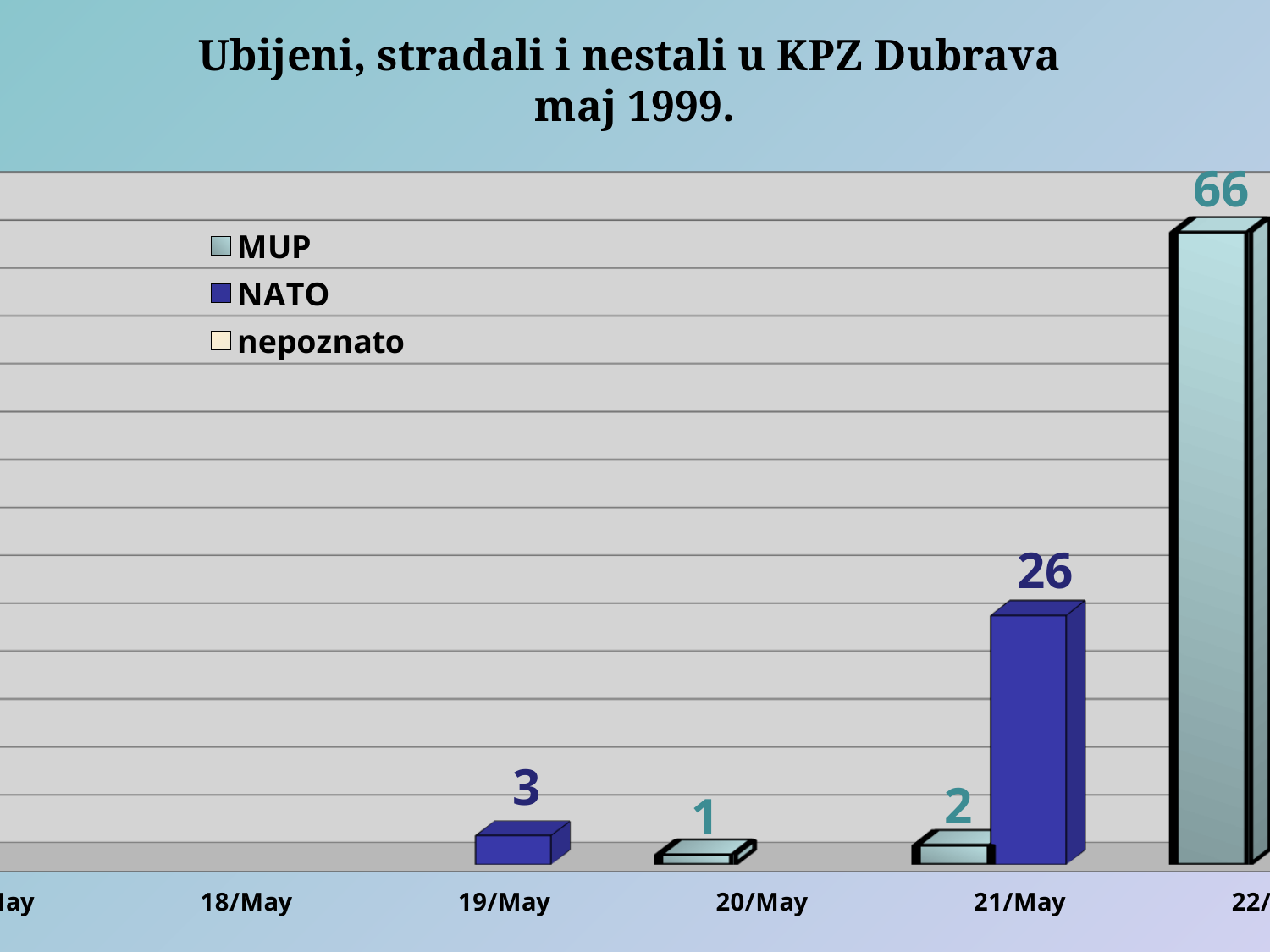
How many series does the legend list? 3 On 21/May, which series has the larger value, MUP or NATO? NATO Which series does the tallest bar on the chart belong to? MUP What is the value for NATO on 19/May? 3 What kind of chart is shown on the slide? Bar chart What is the value for MUP on 21/May? 2 What is the combined value of MUP and NATO on 21/May? 28 What is the value for NATO on 21/May? 26 What is the highest data label value shown on the chart? 66 What are the three entries in the chart's legend? MUP, NATO, nepoznato What is the value for MUP on 20/May? 1 On 21/May, how much larger is the NATO value than the MUP value? 24